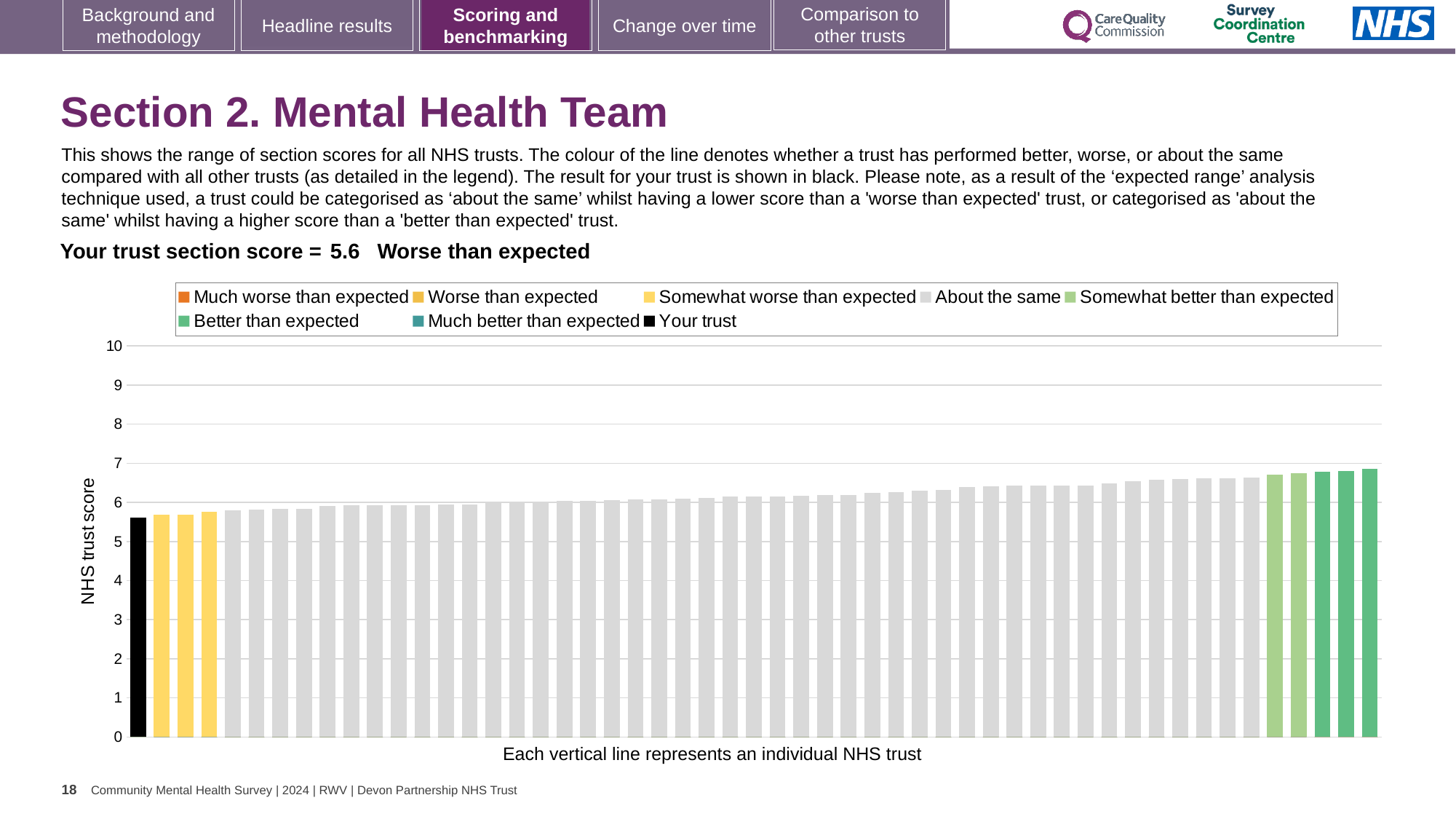
What is the section score for your trust shown on the slide? 5.6 Do the bar values rise or fall from left to right along the x axis? rise Which bar has the lowest score in the chart? Your trust (the black bar) Is the value for your trust greater or less than 6? less Which is larger: the score for your trust or the score of the rightmost bar? the rightmost bar How many entries does the chart legend list? 8 How many bars are coloured 'Somewhat worse than expected' (yellow)? 3 What is the label on the vertical axis of the chart? NHS trust score What kind of chart is shown on the slide? bar chart Is the value of the rightmost (highest) bar greater or less than 6? greater What colour is the bar representing your trust? black Is the value of the rightmost (highest) bar greater or less than 7? less